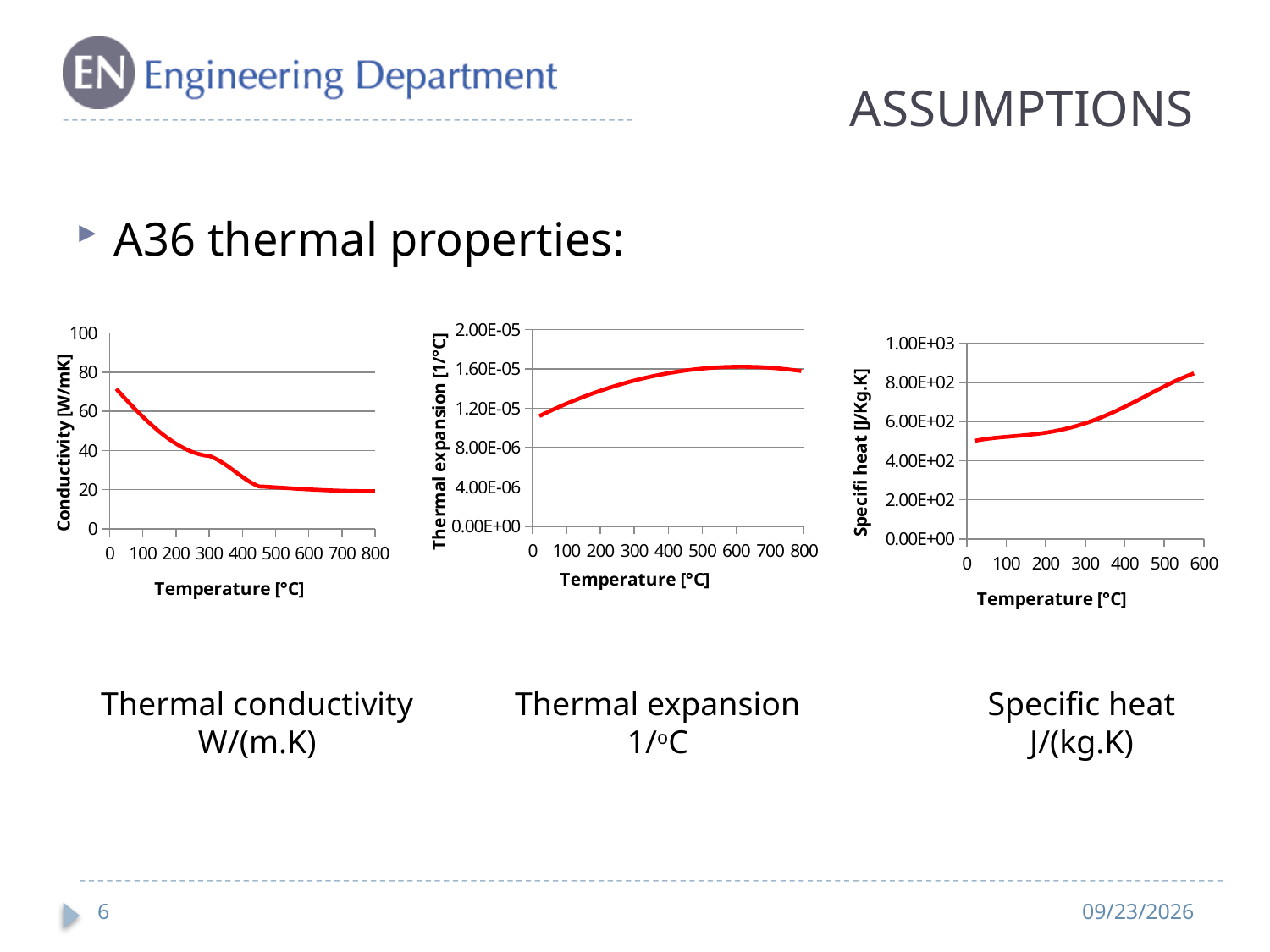
In the specific heat chart on the right, does specific heat rise or fall as temperature increases? rise What is the x-axis label of the thermal conductivity chart on the left? Temperature [°C] What is the y-axis label of the specific heat chart on the right? Specifi heat [J/Kg.K] What kind of chart is the thermal conductivity chart on the left? line chart In the thermal conductivity chart on the left, does conductivity rise or fall as temperature increases? fall In the thermal conductivity chart on the left, is the conductivity at 0 °C greater or less than 60? greater In the specific heat chart on the right, is the value at 500 °C greater or less than 6.00E+02? greater In the thermal expansion chart in the middle, is the value at 600 °C greater or less than 1.20E-05? greater In the thermal expansion chart in the middle, does thermal expansion generally rise or fall as temperature increases from 0 to 600 °C? rise